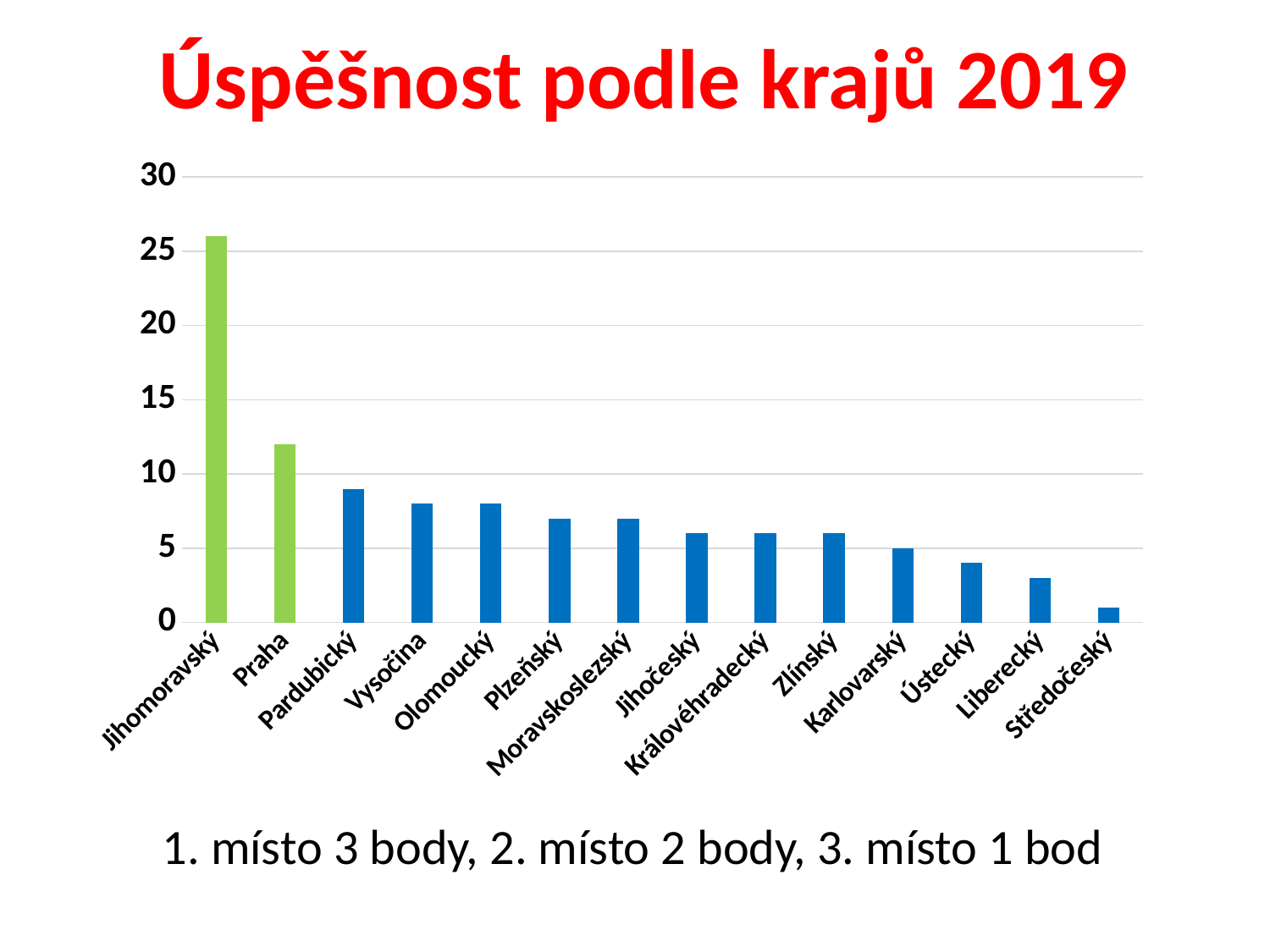
Do the values rise or fall from left to right along the x axis? fall Which region has the highest value in the chart? Jihomoravský What is the title of the chart on the slide? Úspěšnost podle krajů 2019 Which has a larger value, Praha or Pardubický? Praha Is the value for Praha greater or less than 10? greater What kind of chart is shown on the slide? bar chart Which has a larger value, Liberecký or Středočeský? Liberecký Is the value for Pardubický greater or less than 10? less Which region has the lowest value in the chart? Středočeský Is the value for Jihomoravský greater or less than 25? greater How many regions are shown on the x axis of the chart? 14